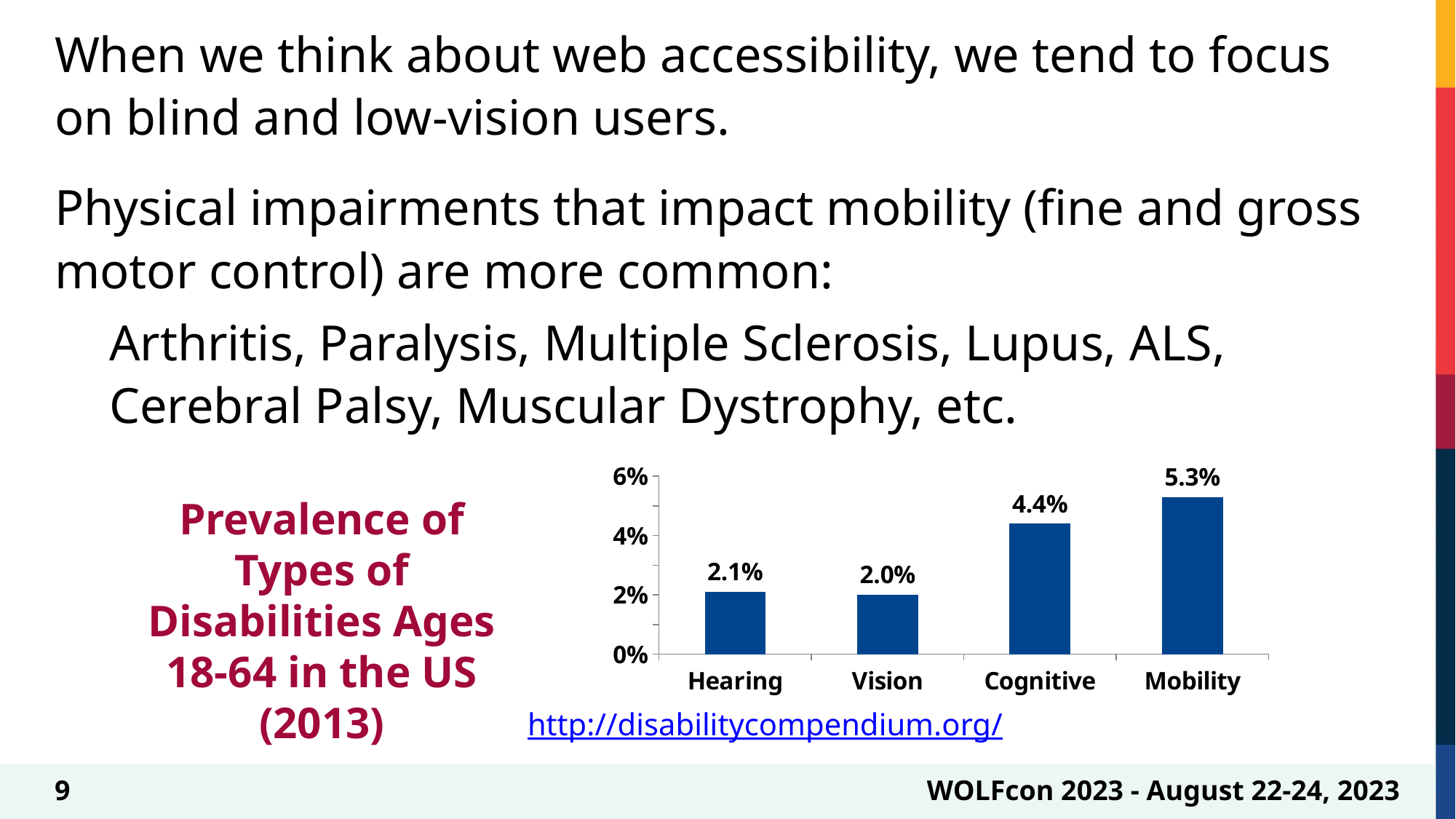
What is the prevalence value for Hearing? 2.1% What is the difference between the Cognitive and Hearing values? 2.3% How many disability types are shown in the chart? 4 What is the prevalence value for Cognitive? 4.4% Which disability type has the lowest prevalence? Vision What is the difference between the Mobility and Vision values? 3.3% What is the prevalence value for Vision? 2.0% Which disability type has the highest prevalence? Mobility What is the title of the chart? Prevalence of Types of Disabilities Ages 18-64 in the US (2013) What kind of chart is shown on the slide? Bar chart Which is larger, the value for Cognitive or the value for Mobility? Mobility What is the prevalence value for Mobility? 5.3%